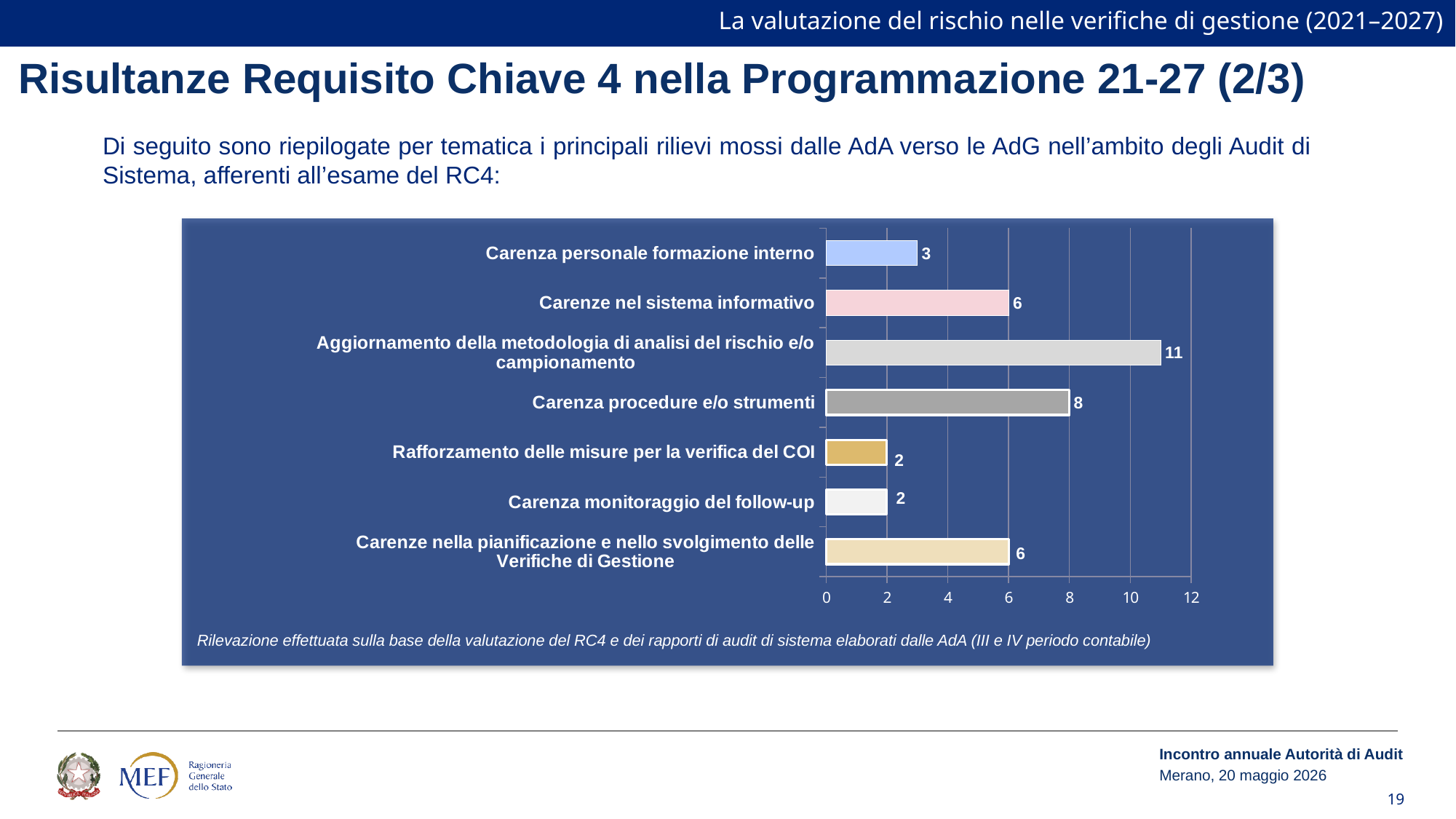
What is the value for "Aggiornamento della metodologia di analisi del rischio e/o campionamento"? 11 What is the value for "Carenza procedure e/o strumenti"? 8 Which category has the highest value? Aggiornamento della metodologia di analisi del rischio e/o campionamento What is the highest value shown on the x axis of the chart? 12 What is the difference between the values for "Aggiornamento della metodologia di analisi del rischio e/o campionamento" and "Carenza procedure e/o strumenti"? 3 What is the value for "Carenza personale formazione interno"? 3 How many categories are shown in the chart? 7 What kind of chart is shown on the slide? Bar chart What is the difference between the values for "Carenza procedure e/o strumenti" and "Carenza monitoraggio del follow-up"? 6 What is the value for "Rafforzamento delle misure per la verifica del COI"? 2 Which is larger, the value for "Carenze nel sistema informativo" or the value for "Carenza personale formazione interno"? Carenze nel sistema informativo What is the value for "Carenze nel sistema informativo"? 6